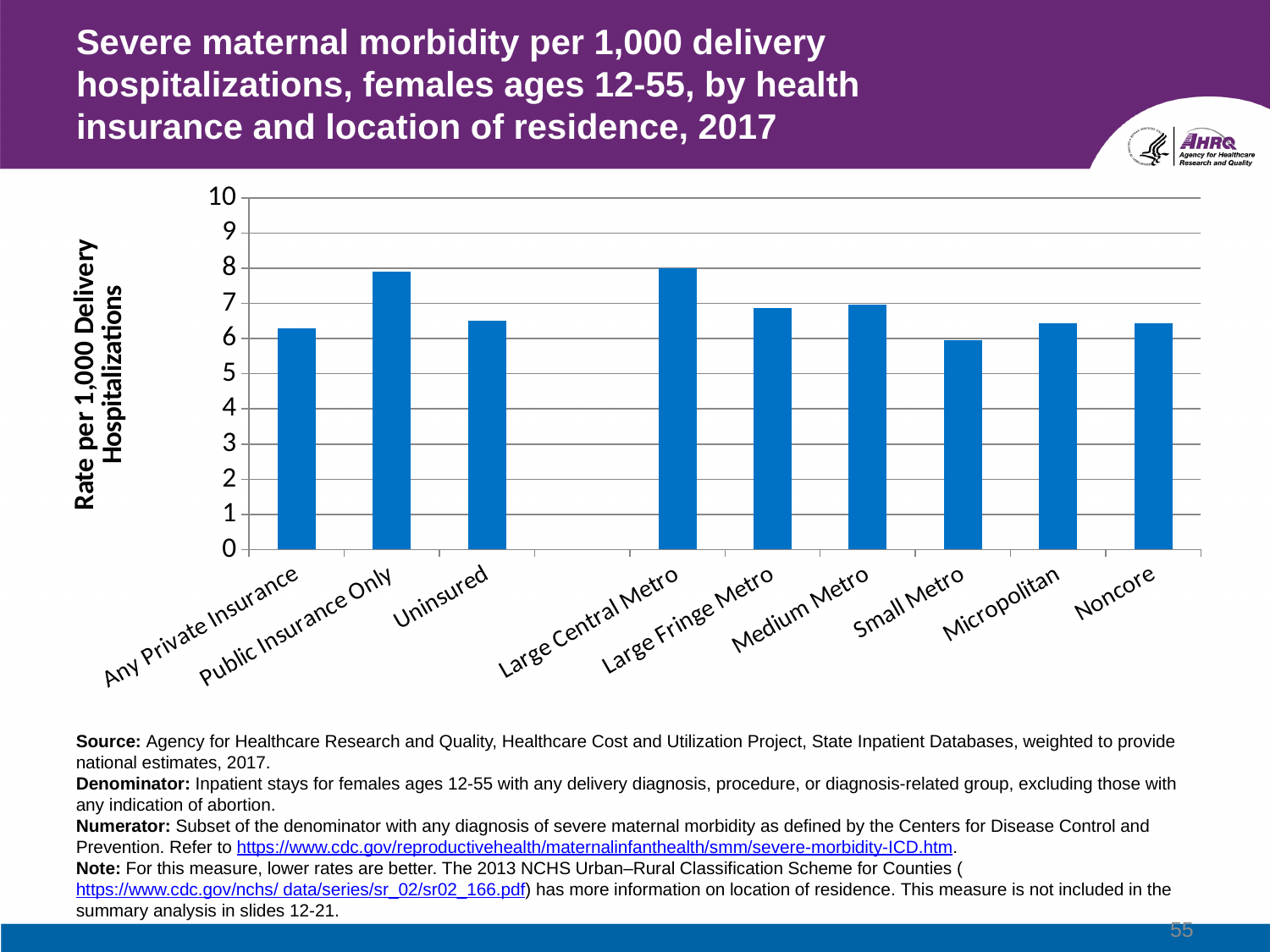
What is the label on the y axis of the chart? Rate per 1,000 Delivery Hospitalizations Which is larger, the value for Public Insurance Only or the value for Uninsured? Public Insurance Only Which is larger, the value for Any Private Insurance or the value for Public Insurance Only? Public Insurance Only Is the value for Uninsured greater or less than 7? less Which is larger, the value for Medium Metro or the value for Small Metro? Medium Metro Which category has the lowest rate of severe maternal morbidity? Small Metro What kind of chart is shown on the slide? bar chart Is the value for Public Insurance Only greater or less than 7? greater How many categories are shown on the x axis of the chart? 9 Is the value for Any Private Insurance greater or less than 6? greater